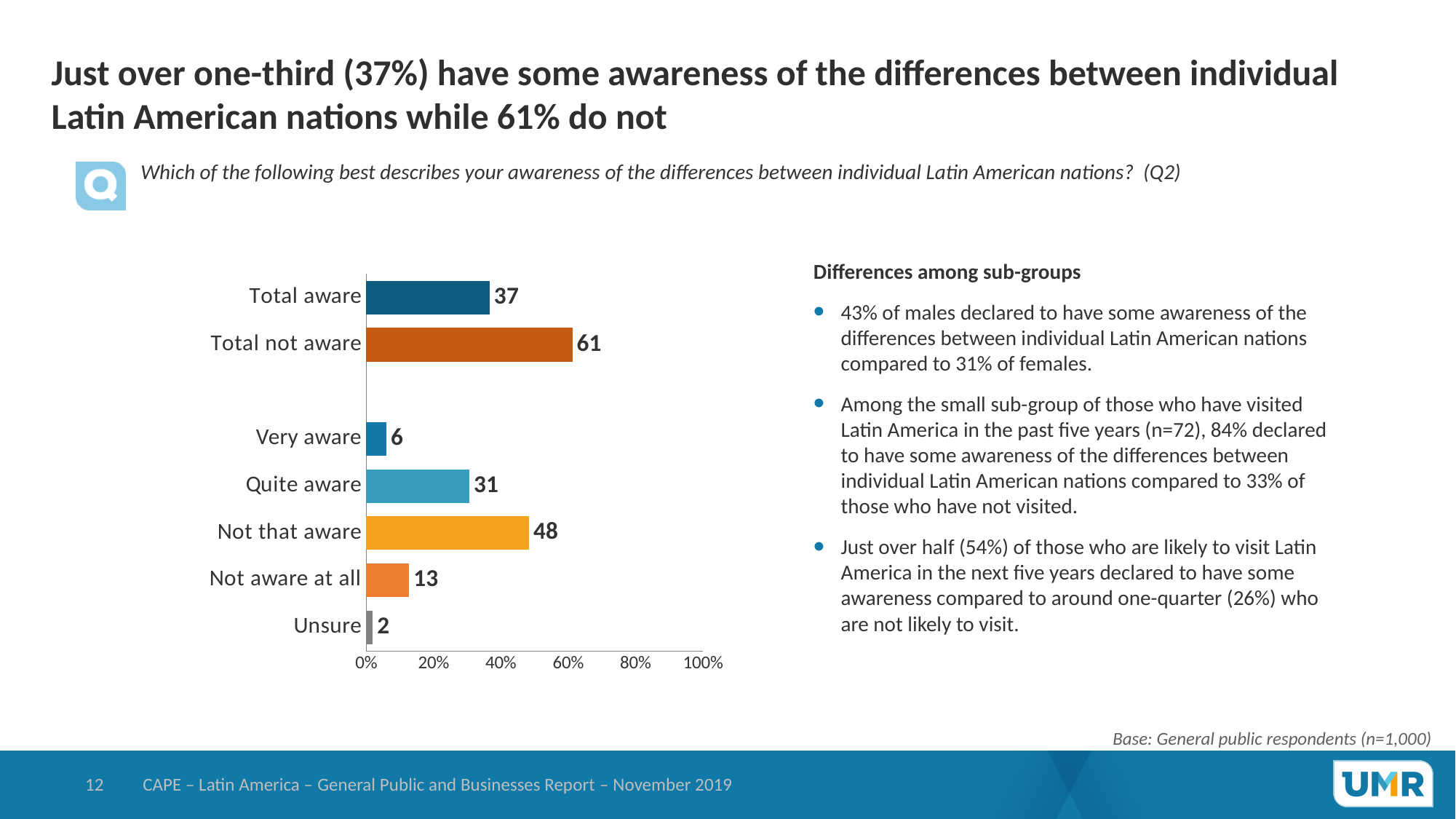
Which is larger, Quite aware or Not that aware? Not that aware What is the difference between Total not aware and Total aware? 24 What is the value for Unsure? 2 What is the value for Total aware? 37 What is the difference between Quite aware and Not aware at all? 18 What is the value for Not that aware? 48 Is the value for Total not aware greater or less than 40%? greater Which category has the highest value? Total not aware What kind of chart is shown on the slide? Bar chart Which category has the lowest value? Unsure How many categories are shown on the chart? 7 What is the value for Very aware? 6